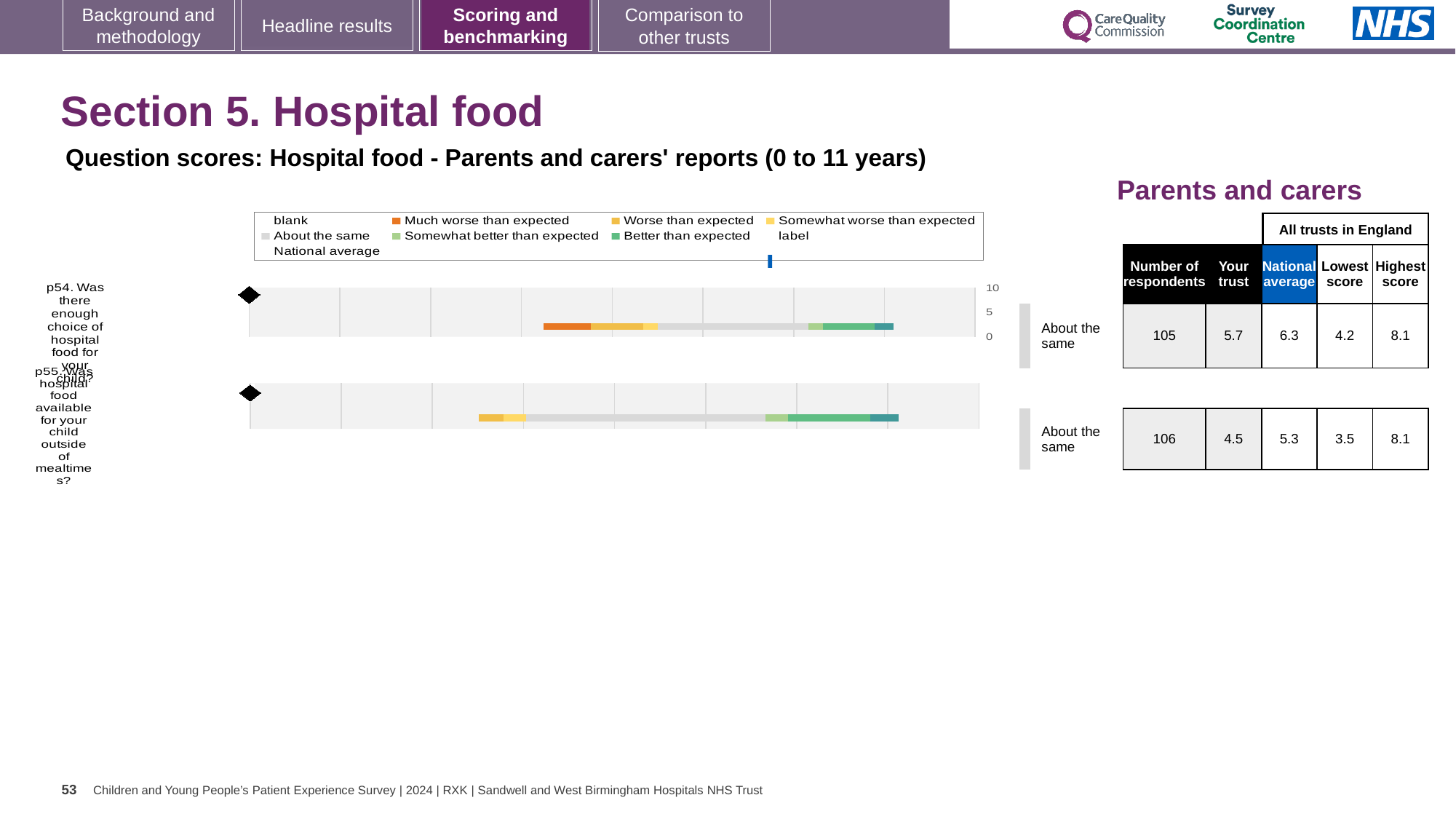
What is the difference between the national average and the 'Your trust' score for p54? 0.6 What is the 'Your trust' score for p54 (enough choice of hospital food for your child)? 5.7 What is the highest score across all trusts in England for p54? 8.1 What benchmark category is shown for p55 (hospital food available outside of mealtimes)? About the same How many respondents answered question p54? 105 How many survey questions are plotted in the hospital food chart? 2 Which question has the higher 'Your trust' score, p54 or p55? p54 What is the lowest score across all trusts in England for p55? 3.5 What is the maximum value shown on the score axis of the chart? 10 What is the difference between the highest and lowest scores for p55? 4.6 What is the national average score for p55 (hospital food available outside of mealtimes)? 5.3 What type of chart is used to show the question scores for hospital food? bar chart